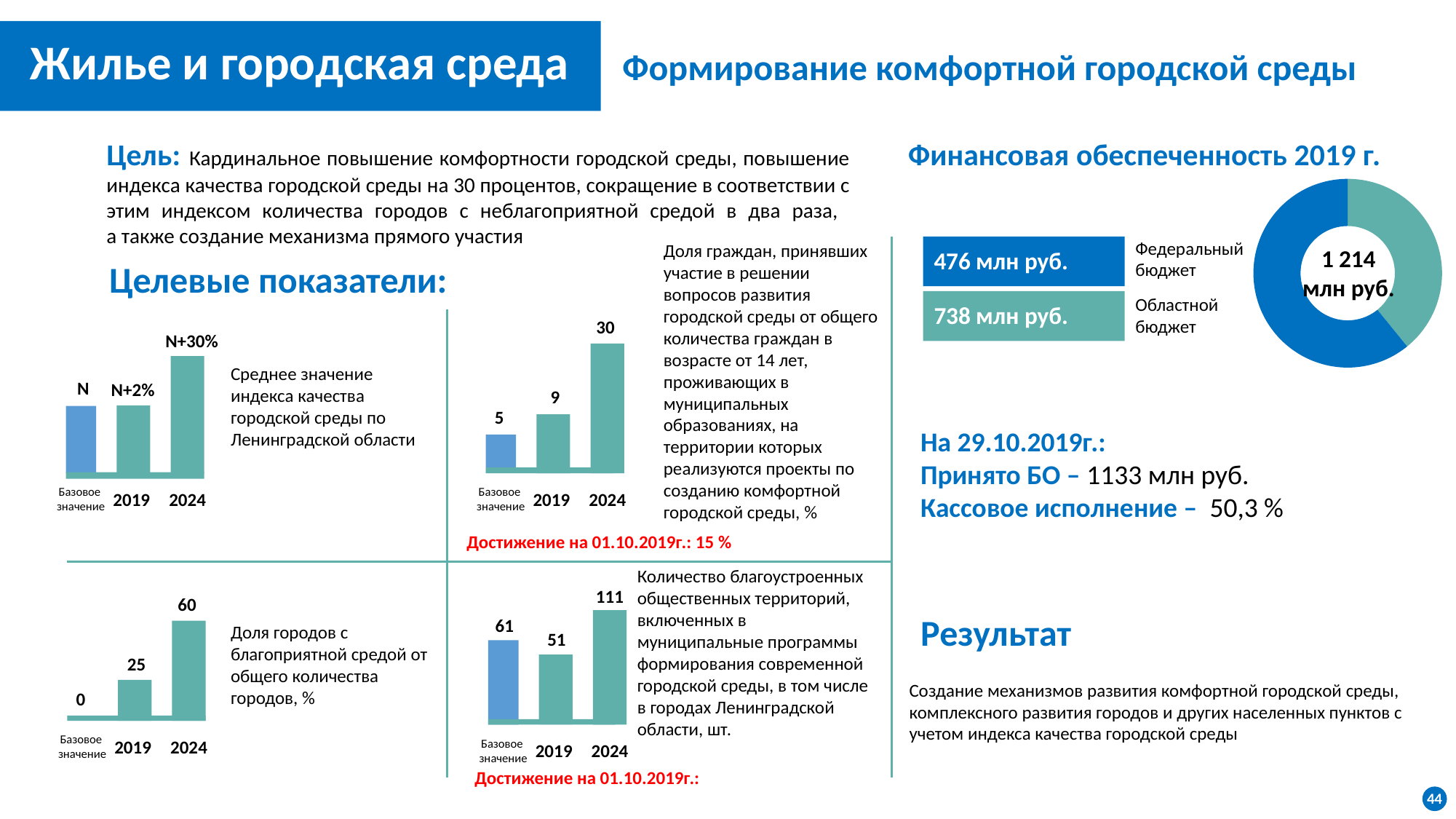
In the 'Финансовая обеспеченность 2019 г.' chart, which is larger: the federal budget or the regional budget? Областной бюджет How many categories are shown in the chart for the share of cities with a favourable environment (bottom left)? 3 What kind of chart is used for 'Финансовая обеспеченность 2019 г.'? Donut (pie) chart In the chart for the share of citizens participating in urban environment development (top middle), what is the value for 2024? 30 In the chart for the number of improved public territories (bottom middle), what is the value for 2024? 111 In the chart for the number of improved public territories (bottom middle), which category has the lowest value? 2019 In the chart for the share of cities with a favourable environment (bottom left), what is the value for 2019? 25 In the chart for the share of citizens participating in urban environment development (top middle), what is the base value (Базовое значение)? 5 In the chart for the share of cities with a favourable environment (bottom left), by how much does the 2024 value exceed the 2019 value? 35 In the 'Финансовая обеспеченность 2019 г.' chart, what is the value for the regional budget (Областной бюджет)? 738 млн руб. In the chart for the number of improved public territories (bottom middle), what is the difference between the 2024 value and the base value? 50 In the chart for the average urban environment quality index (top left), what is the label on the 2024 bar? N+30%